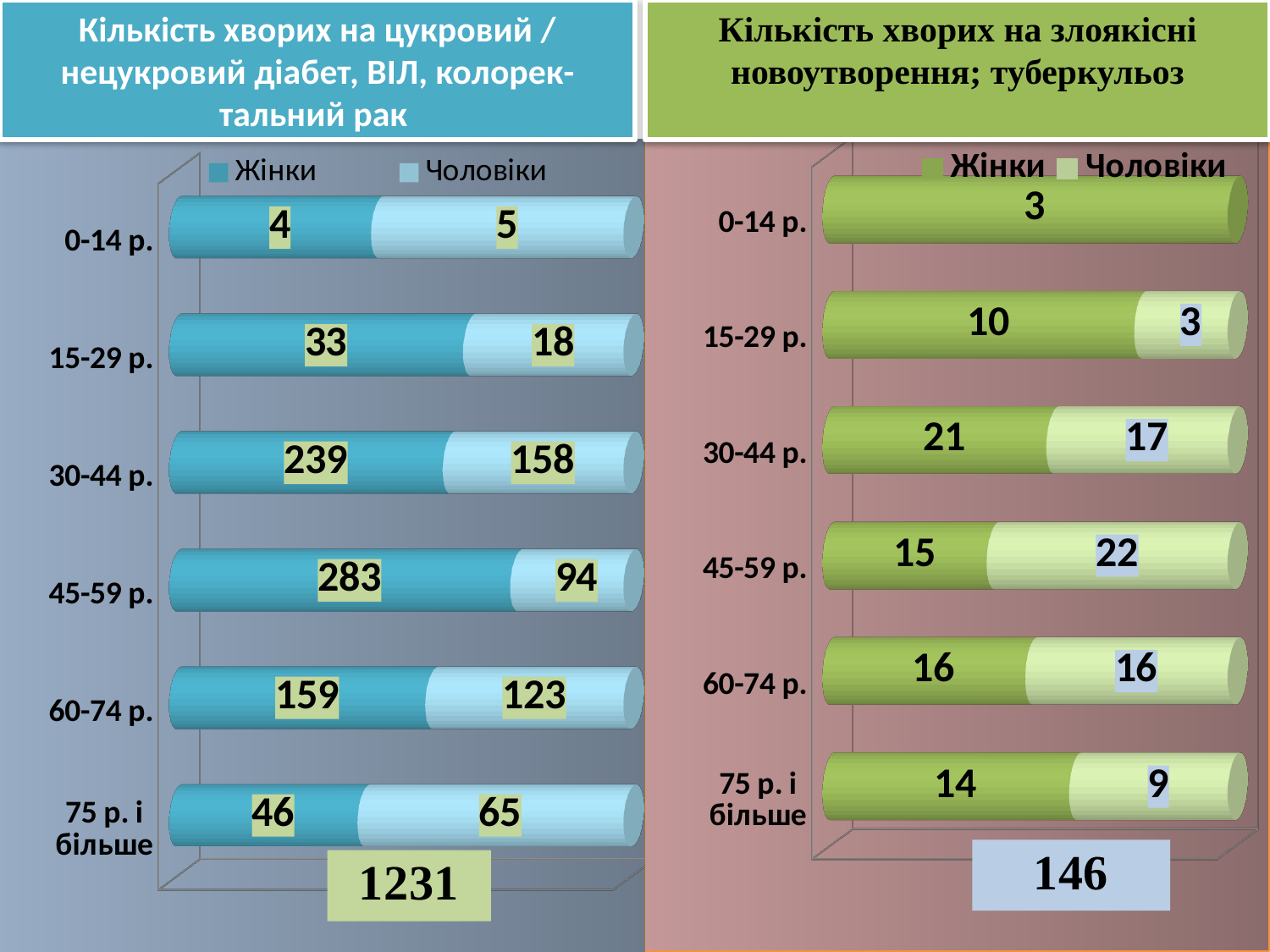
How many age groups are shown in the left chart (diabetes, HIV, colorectal cancer)? 6 In the left chart (diabetes, HIV, colorectal cancer), what is the difference between Жінки and Чоловіки in the 60-74 р. age group? 36 In the left chart (diabetes, HIV, colorectal cancer), what is the value for Чоловіки in the 30-44 р. age group? 158 In the right chart (malignant neoplasms; tuberculosis), what is the total of the stacked bar for 75 р. і більше? 23 How many series does the legend of the right chart (malignant neoplasms; tuberculosis) list? 2 In the right chart (malignant neoplasms; tuberculosis), what is the value for Чоловіки in the 45-59 р. age group? 22 In the left chart (diabetes, HIV, colorectal cancer), which age group has the lowest value for Чоловіки? 0-14 р. What kind of chart is the left chart (diabetes, HIV, colorectal cancer)? Stacked bar chart In the right chart (malignant neoplasms; tuberculosis), which is larger in the 15-29 р. age group, Жінки or Чоловіки? Жінки In the left chart (diabetes, HIV, colorectal cancer), what is the value for Жінки in the 45-59 р. age group? 283 In the left chart (diabetes, HIV, colorectal cancer), which age group has the highest value for Жінки? 45-59 р. In the right chart (malignant neoplasms; tuberculosis), what is the value for Жінки in the 30-44 р. age group? 21